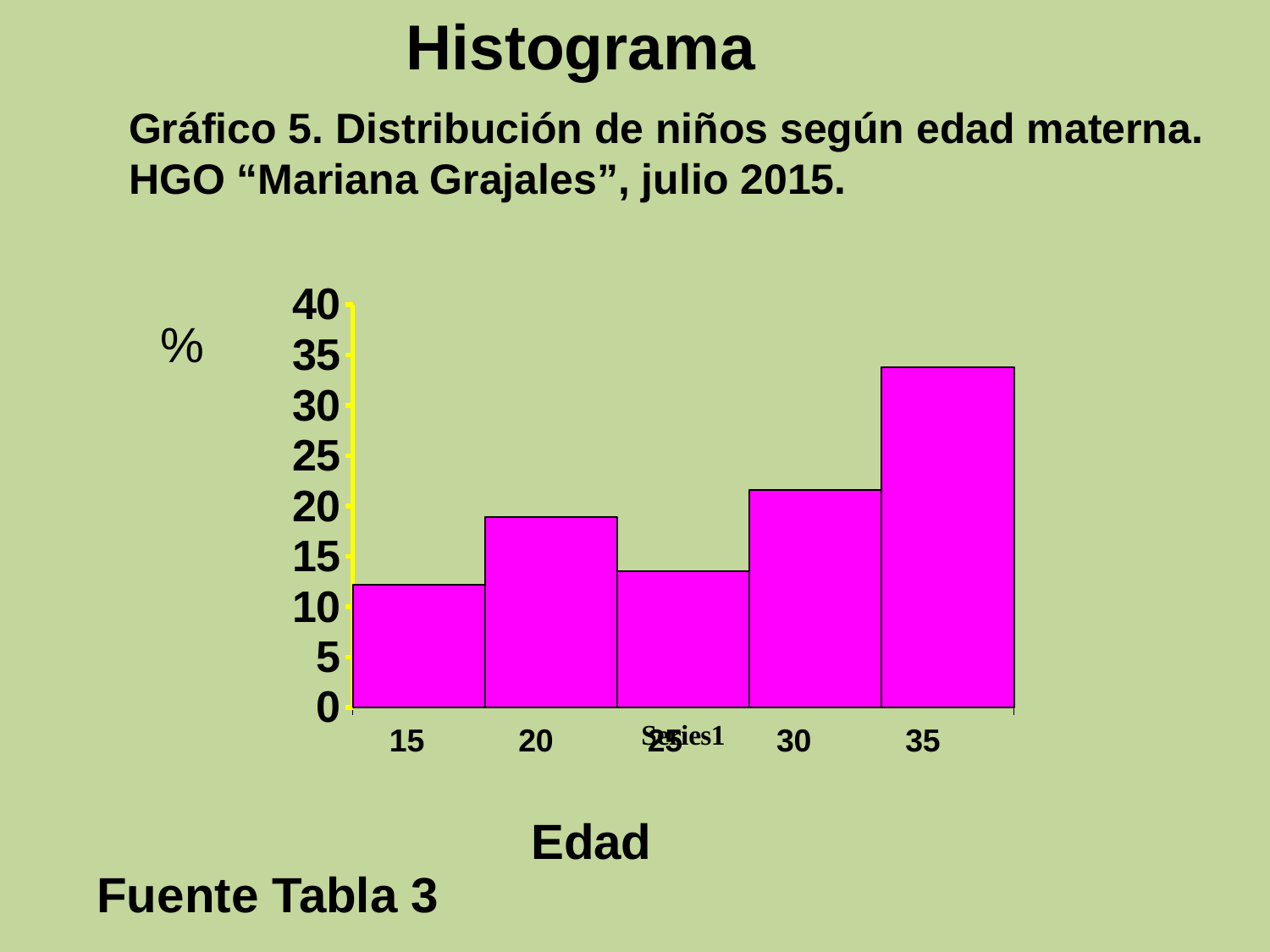
What kind of chart is shown on the slide? bar chart (histogram) Is the value for age 35 greater or less than 30? greater Is the value for age 30 greater or less than 20? greater Is the value for age 25 greater or less than 15? less Which is larger, the value for age 20 or the value for age 30? 30 What is the label of the x axis? Edad How many bars are plotted in the chart? 5 Which age category has the highest value? 35 What colour are the bars in the chart? magenta